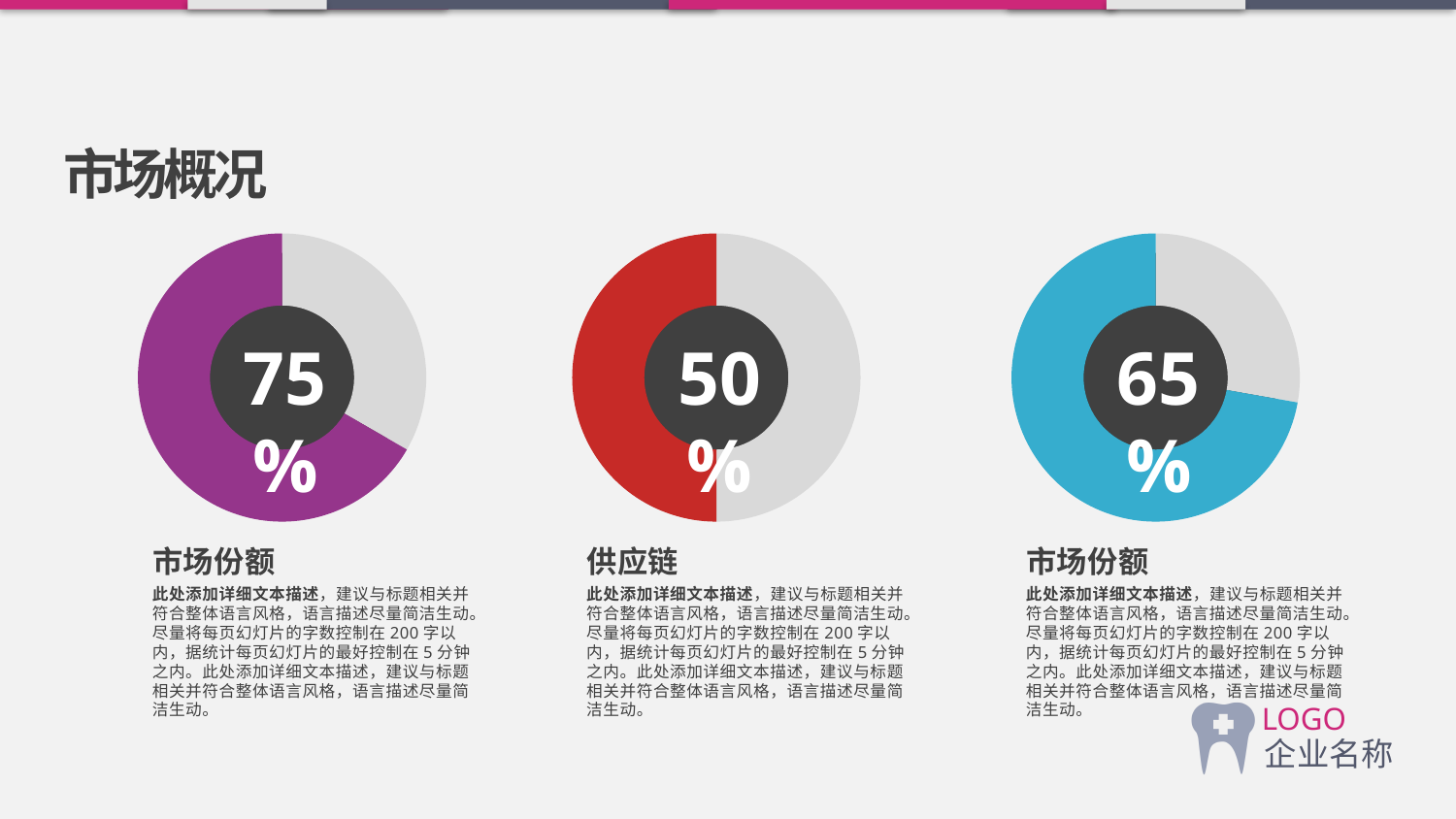
What is the label under the middle donut chart? 供应链 What is the difference between the percentage in the left donut chart and the percentage in the right donut chart? 10% How many donut charts are on the slide? 3 What value is shown in the centre of the middle donut chart (供应链)? 50% What value is shown in the centre of the right donut chart? 65% Which of the three donut charts shows the lowest percentage? The middle chart (50%) Which is larger, the percentage in the right donut chart or the percentage in the middle donut chart? The right chart (65%) What is the difference between the percentage in the left donut chart and the percentage in the middle donut chart? 25% Which of the three donut charts shows the highest percentage? The left chart (75%) What value is shown in the centre of the left donut chart? 75% What colour is the filled portion of the middle donut chart? Red What kind of chart is used to show the percentages on this slide? Donut chart